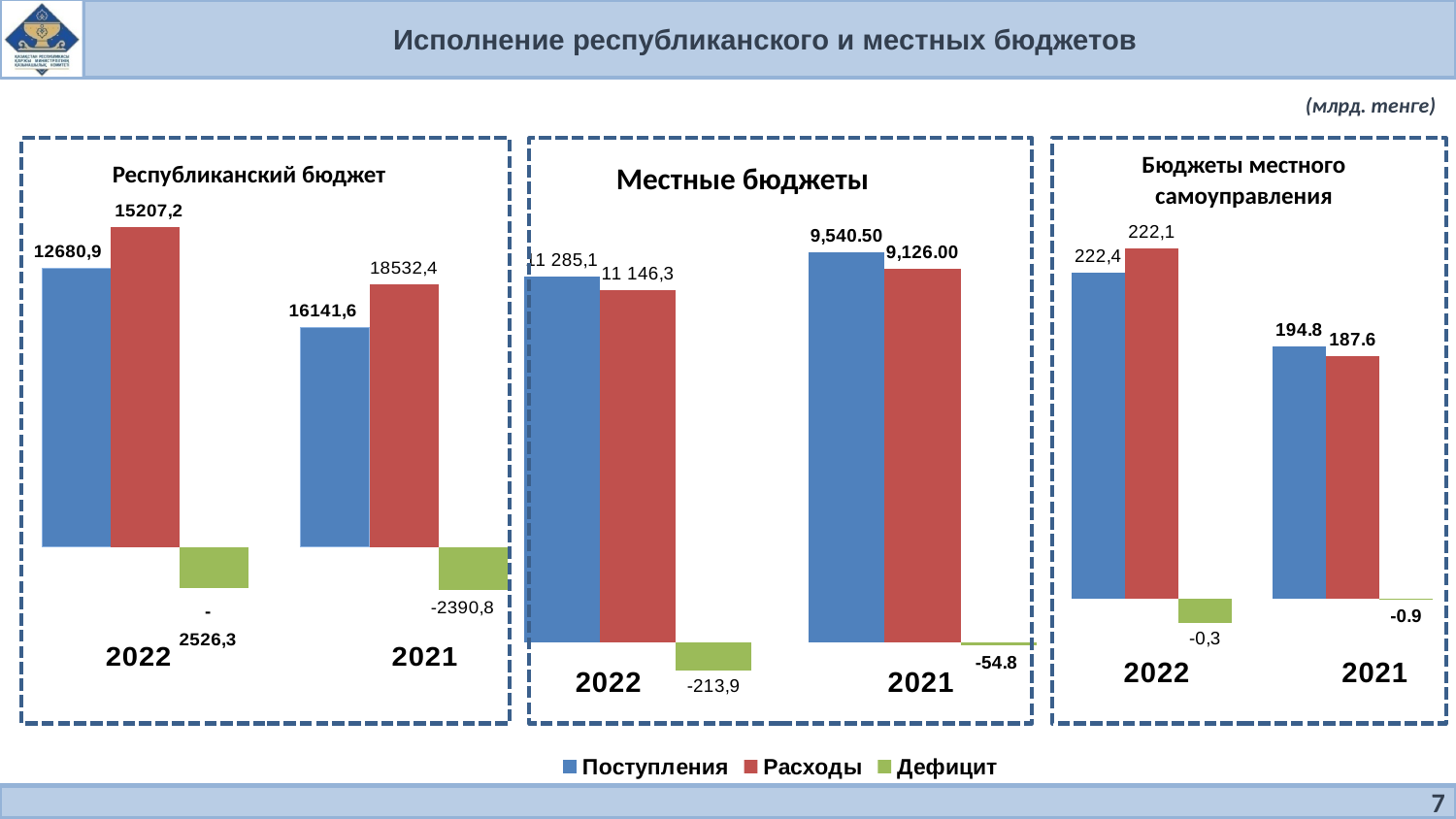
In the 'Республиканский бюджет' chart, what is the value of Расходы for 2021? 18532,4 Which series is shown in green in the legend? Дефицит What kind of chart is the 'Местные бюджеты' chart? Bar chart How many series does the legend at the bottom of the slide list? 3 In the 'Республиканский бюджет' chart, what is the Дефицит value for 2021? -2390,8 In the 'Бюджеты местного самоуправления' chart, what is the Дефицит value for 2022? -0,3 In the 'Бюджеты местного самоуправления' chart, what is the value of Расходы for 2021? 187.6 In the 'Местные бюджеты' chart, what is the value of Поступления for 2022? 11 285,1 In the 'Республиканский бюджет' chart, what is the value of Поступления for 2022? 12680,9 In the 'Местные бюджеты' chart, what is the Дефицит value for 2021? -54.8